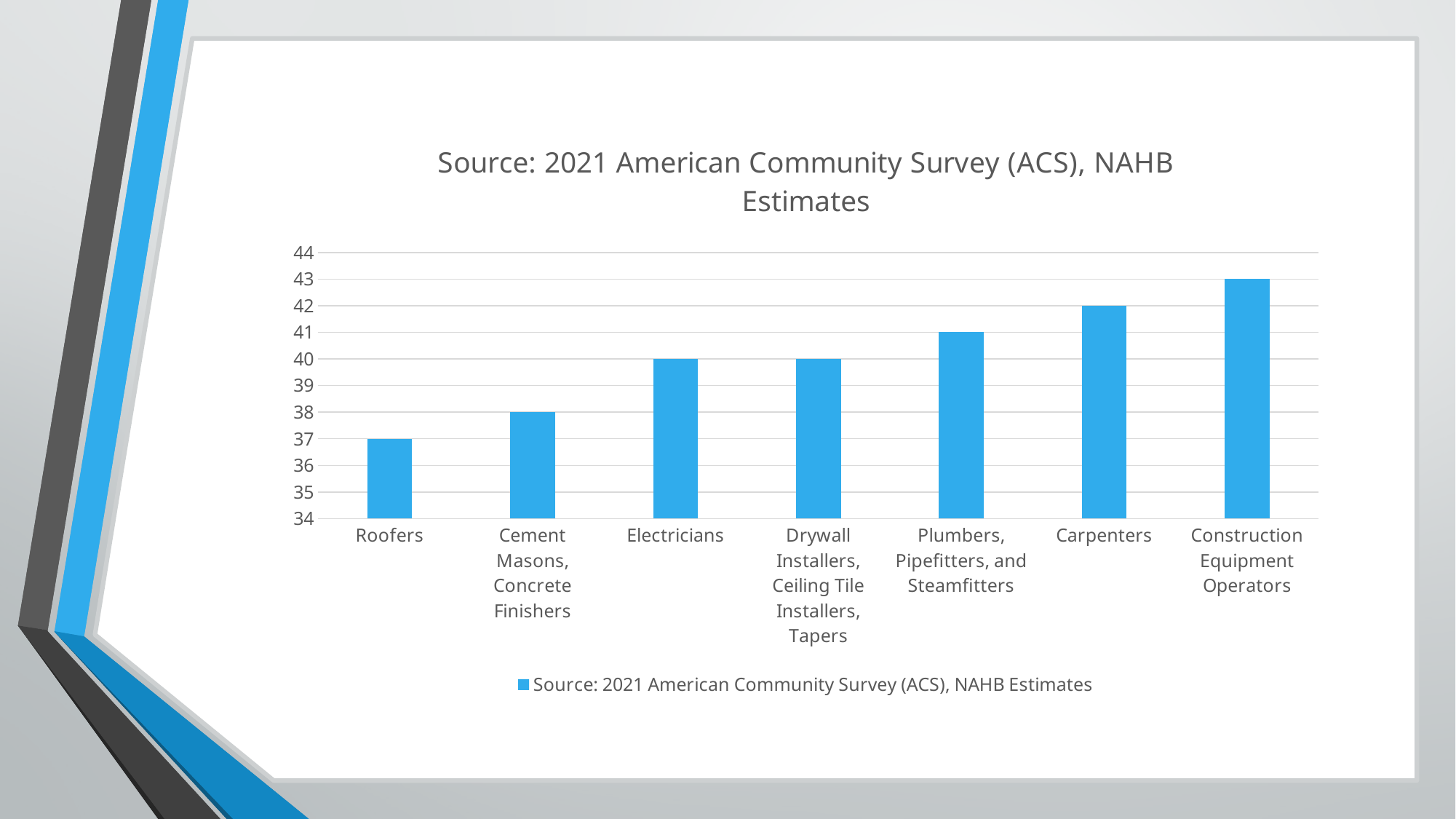
Which is larger, the value for Carpenters or the value for Electricians? Carpenters Do the values generally rise or fall from left to right along the x axis? rise What is the value for Plumbers, Pipefitters, and Steamfitters? 41 What is the title of the chart? Source: 2021 American Community Survey (ACS), NAHB Estimates Is the value for Cement Masons, Concrete Finishers greater or less than 40? less Which category has the lowest value? Roofers What is the difference between the values for Construction Equipment Operators and Roofers? 6 What kind of chart is shown on the slide? bar chart What is the value for Roofers? 37 What is the value for Carpenters? 42 How many categories are shown on the x axis? 7 Which category has the highest value? Construction Equipment Operators